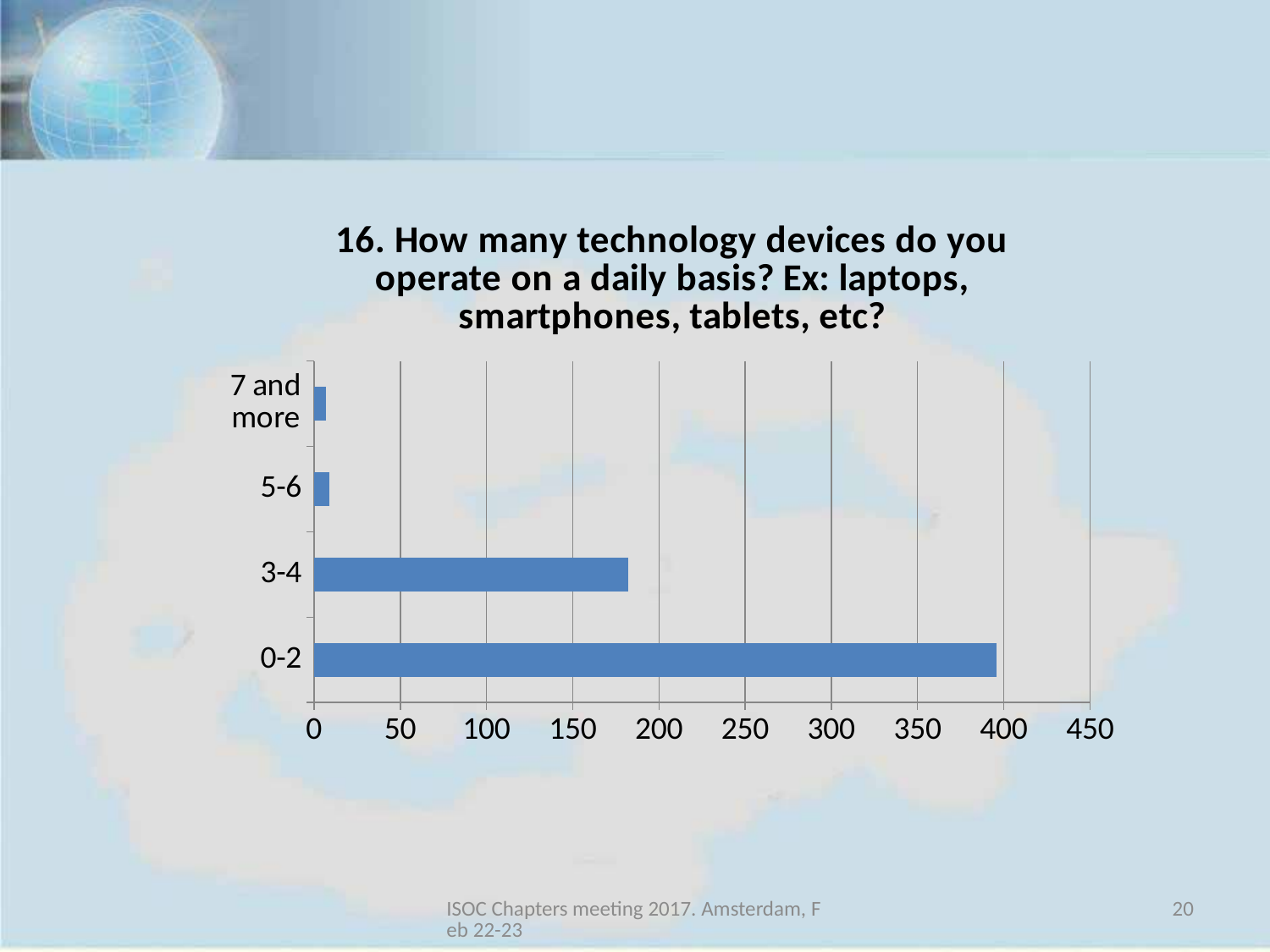
Which category has the highest value? 0-2 How many categories are shown on the chart? 4 What is the highest value shown on the horizontal axis of the chart? 450 Which is larger, the value for 0-2 or the value for 3-4? 0-2 Is the value for 0-2 greater or less than 350? greater Is the value for 3-4 greater or less than 150? greater Is the value for 5-6 greater or less than 50? less What kind of chart is shown on the slide? bar chart Which is larger, the value for 3-4 or the value for 5-6? 3-4